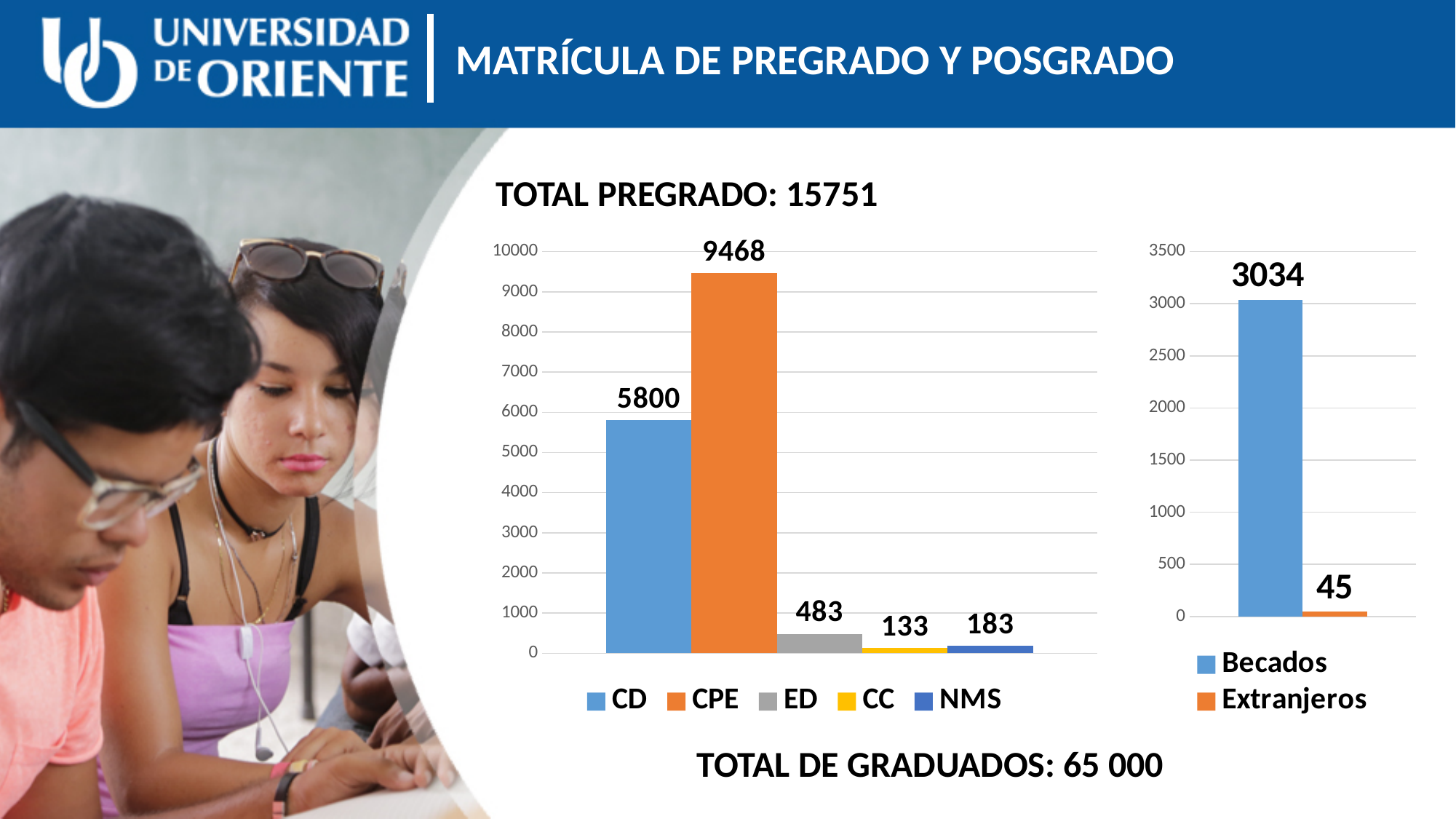
What kind of chart is the right chart showing Becados and Extranjeros? Bar chart In the left chart under TOTAL PREGRADO, what is the difference between the values for CPE and CD? 3668 In the left chart under TOTAL PREGRADO, how many categories does the legend list? 5 In the right chart, what is the value for Extranjeros? 45 In the right chart, what is the value for Becados? 3034 In the left chart under TOTAL PREGRADO, what is the value for ED? 483 In the left chart under TOTAL PREGRADO, which is larger, the value for NMS or the value for CC? NMS In the left chart under TOTAL PREGRADO, what is the value for CPE? 9468 In the left chart under TOTAL PREGRADO, which category has the highest value? CPE In the right chart, what is the difference between the values for Becados and Extranjeros? 2989 In the left chart under TOTAL PREGRADO, what is the value for CD? 5800 In the left chart under TOTAL PREGRADO, which category has the lowest value? CC